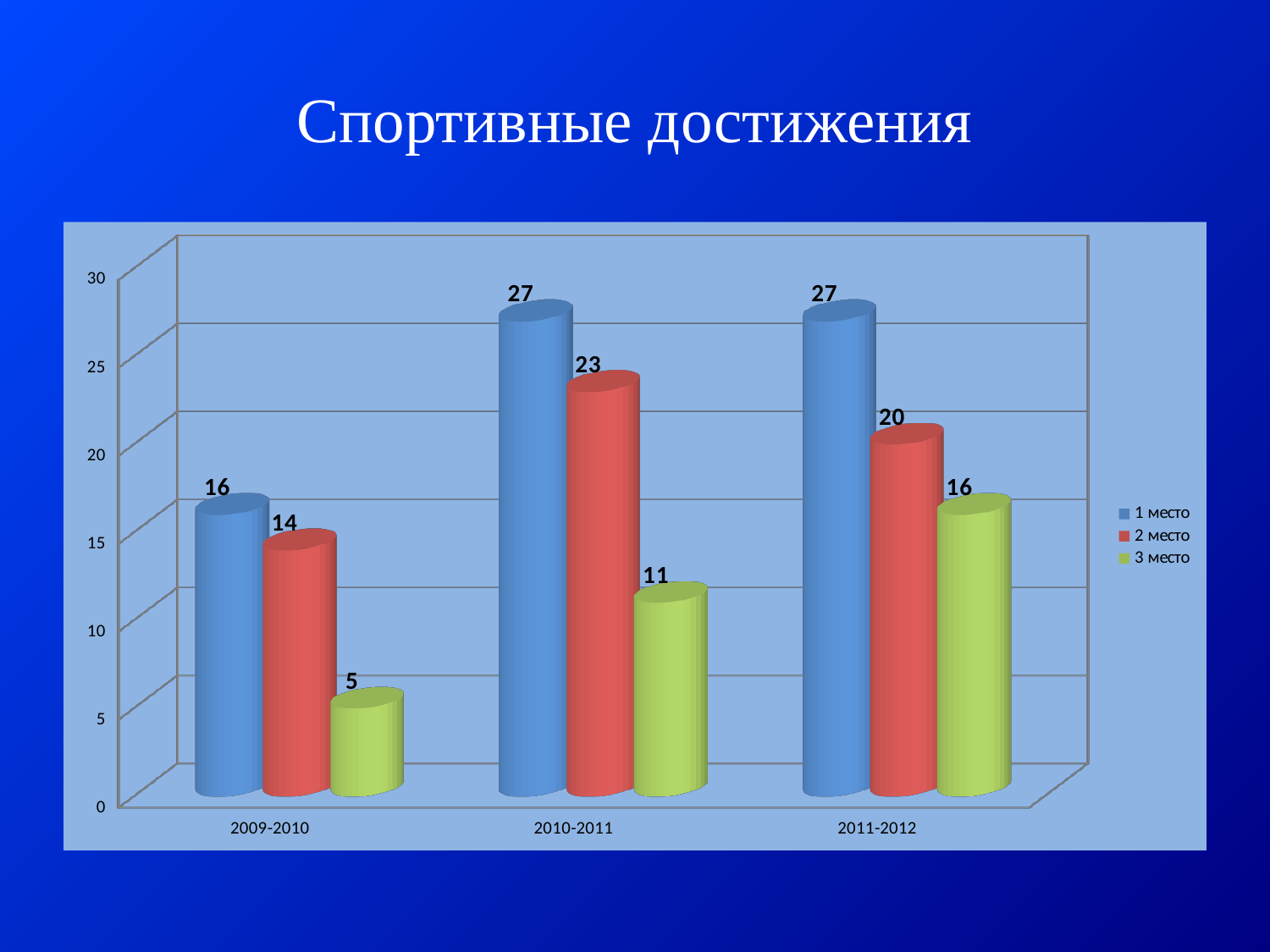
How many seasons are shown on the x axis? 3 How many series does the legend list? 3 What is the value for 1 место in 2009-2010? 16 What is the title of the chart? Спортивные достижения What is the value for 2 место in 2011-2012? 20 Which is larger: 3 место in 2011-2012 or 3 место in 2010-2011? 3 место in 2011-2012 What kind of chart is shown on the slide? bar chart What is the value for 3 место in 2010-2011? 11 Which season has the highest value for 2 место? 2010-2011 What is the difference between 2 место in 2010-2011 and 2 место in 2009-2010? 9 Does the value for 3 место rise or fall from 2009-2010 to 2011-2012? rise Which season has the lowest value for 3 место? 2009-2010